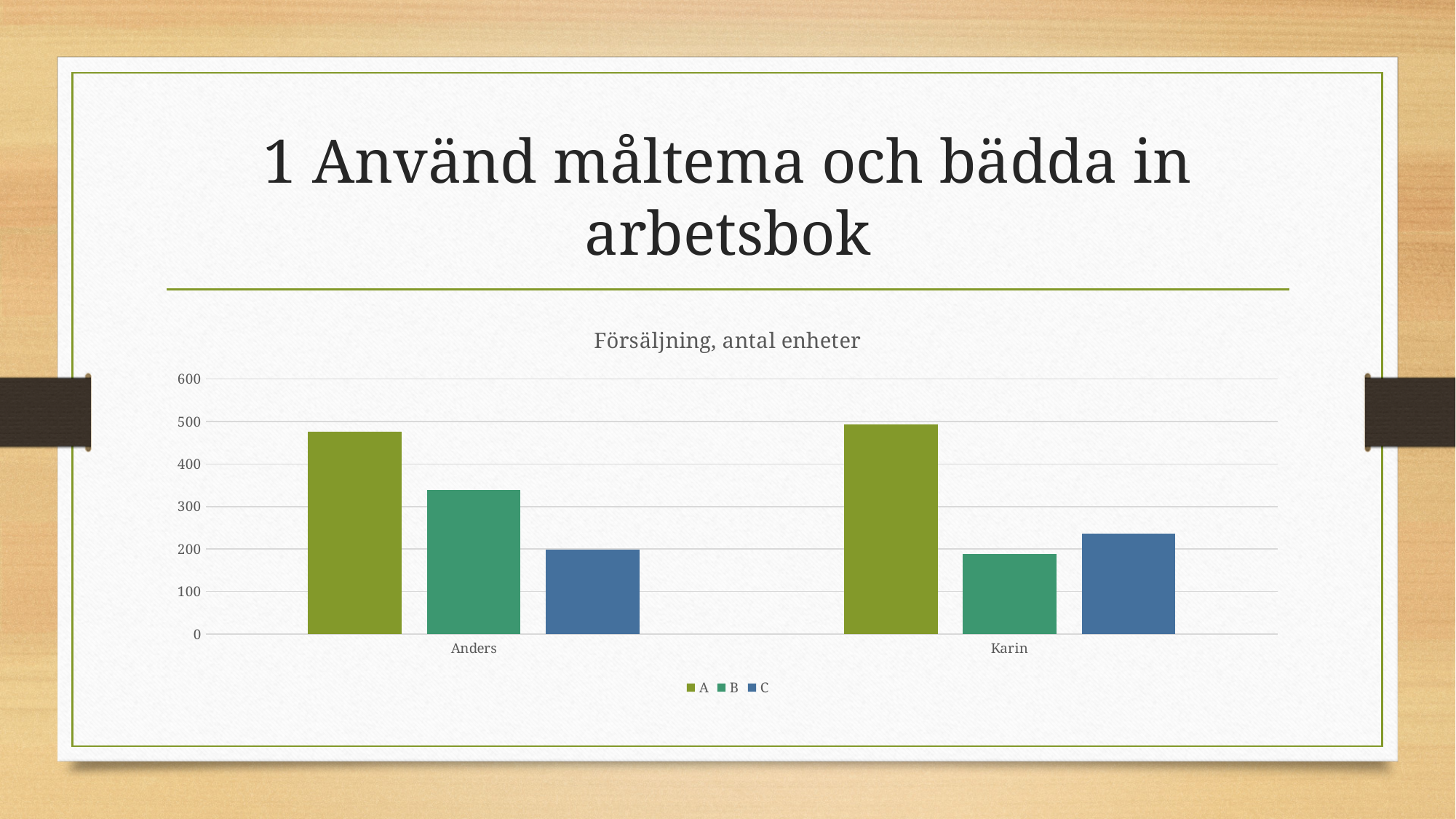
What is the title of the chart? Försäljning, antal enheter How many series does the legend list? 3 Is the value of series C for Karin greater or less than 300? less What type of chart is shown on the slide? bar chart Which series has the lowest bar for Karin? B Is the value of series A for Anders greater or less than 400? greater Is the value of series B for Anders greater or less than 300? greater Which series has the highest bar for Anders? A Which is larger for series B: Anders or Karin? Anders How many categories are shown on the x axis? 2 Which is larger for Karin: series B or series C? C